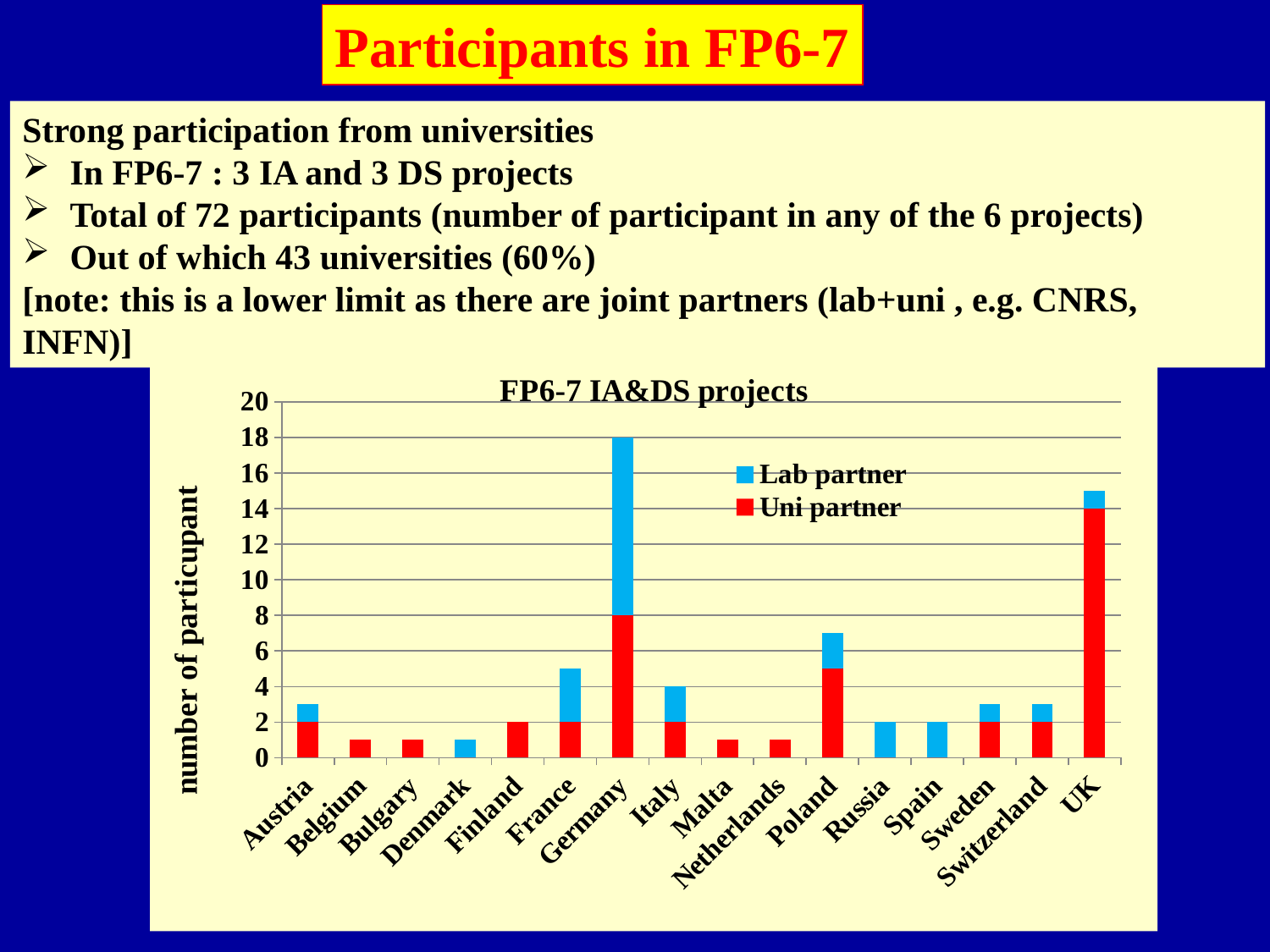
Which country has the larger stacked bar, Germany or the UK? Germany What is the total height of the stacked bar for Italy? 4 How many countries are shown on the x axis of the chart? 16 What is the total height of the stacked bar for Germany? 18 What kind of chart is shown on the slide? bar chart Is the total value for Poland greater or less than 10? less Which country has the tallest stacked bar in the chart? Germany Which colour represents Uni partner in the chart legend? red How many series does the legend list in the FP6-7 IA&DS projects chart? 2 What is the Uni partner value for Germany? 8 What is the title of the chart? FP6-7 IA&DS projects What is the Uni partner value for the UK? 14